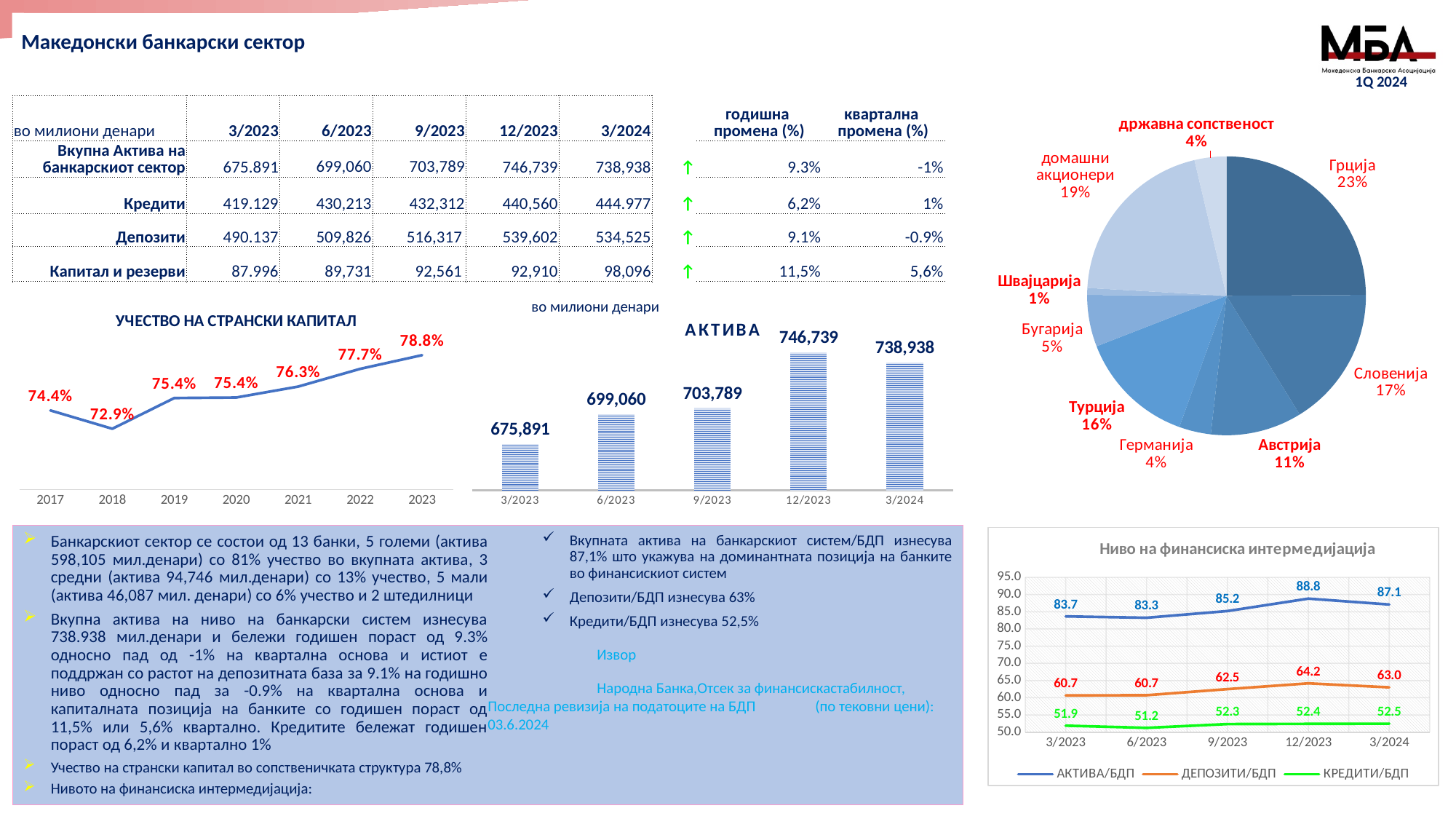
In the 'УЧЕСТВО НА СТРАНСКИ КАПИТАЛ' line chart, which year has the lowest value? 2018 In the pie chart of ownership structure, which is larger: Турција or Словенија? Словенија In the 'Ниво на финансиска интермедијација' chart, how many series does the legend list? 3 In the 'Ниво на финансиска интермедијација' chart, what is the value of ДЕПОЗИТИ/БДП for 12/2023? 64.2 In the 'УЧЕСТВО НА СТРАНСКИ КАПИТАЛ' line chart, how many years are plotted on the x axis? 7 What kind of chart is the 'АКТИВА' chart? Bar chart In the pie chart of ownership structure, what share does Грција hold? 23% In the 'УЧЕСТВО НА СТРАНСКИ КАПИТАЛ' line chart, what is the value for 2023? 78.8% In the 'АКТИВА' bar chart, what is the value for 12/2023? 746,739 In the 'АКТИВА' bar chart, what is the difference between the values for 12/2023 and 3/2024? 7,801 In the pie chart of ownership structure, which slice is the smallest? Швајцарија In the 'АКТИВА' bar chart, which period has the highest value? 12/2023